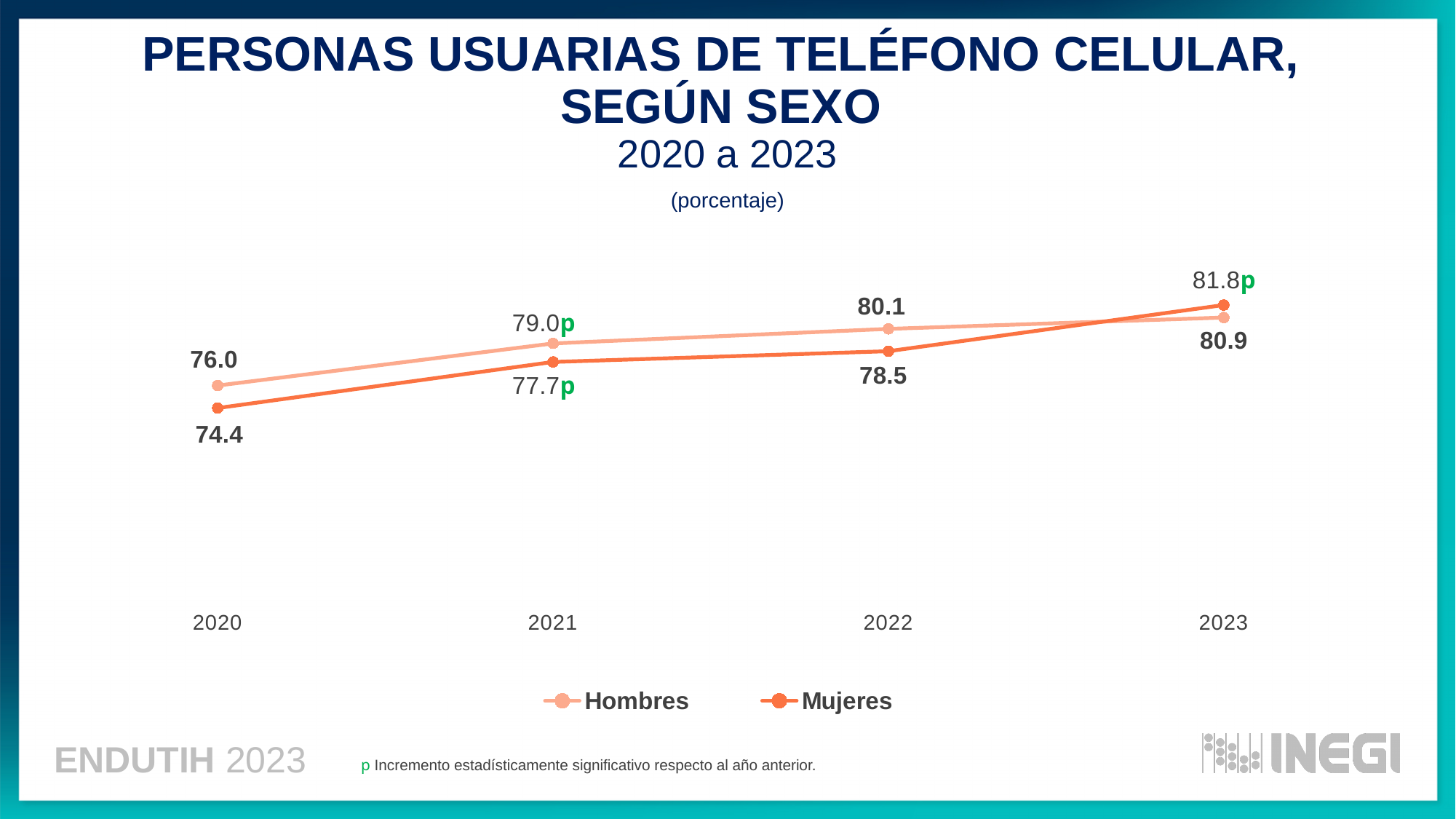
Does the value for Mujeres rise or fall from 2020 to 2023? Rise In which year is the value for Mujeres lowest? 2020 How many years are plotted on the x axis? 4 What is the value for Mujeres in 2021? 77.7 What is the value for Hombres in 2020? 76.0 What is the value for Mujeres in 2023? 81.8 How many series does the legend list? 2 Which series has the larger value in 2023, Hombres or Mujeres? Mujeres What is the difference between the Hombres and Mujeres values in 2020? 1.6 What type of chart is shown on the slide? Line chart What is the value for Hombres in 2022? 80.1 In which year is the value for Hombres highest? 2023